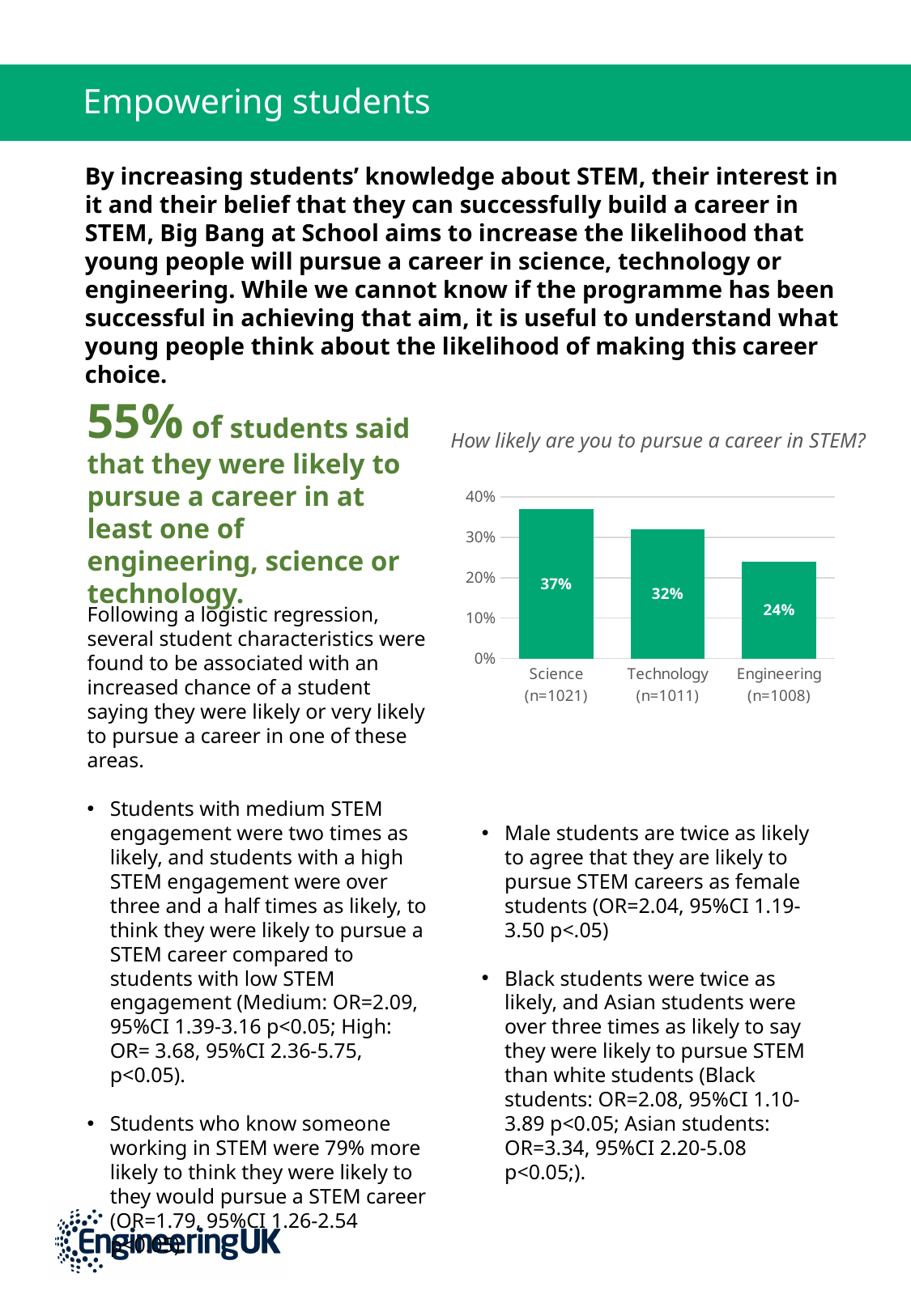
What is the difference in percentage points between Science and Engineering? 13 percentage points What is the difference in percentage points between Technology and Engineering? 8 percentage points What is the title of the chart? How likely are you to pursue a career in STEM? What percentage of students said they were likely to pursue a career in Engineering? 24% What percentage of students said they were likely to pursue a career in Science? 37% Which category has the lowest percentage of students likely to pursue a career in it? Engineering What percentage of students said they were likely to pursue a career in Technology? 32% How many categories are shown in the chart? 3 What kind of chart is shown on the slide? Bar chart Which category has the highest percentage of students likely to pursue a career in it? Science Is the value for Engineering greater or less than 30%? less Which is larger, the value for Science or the value for Technology? Science